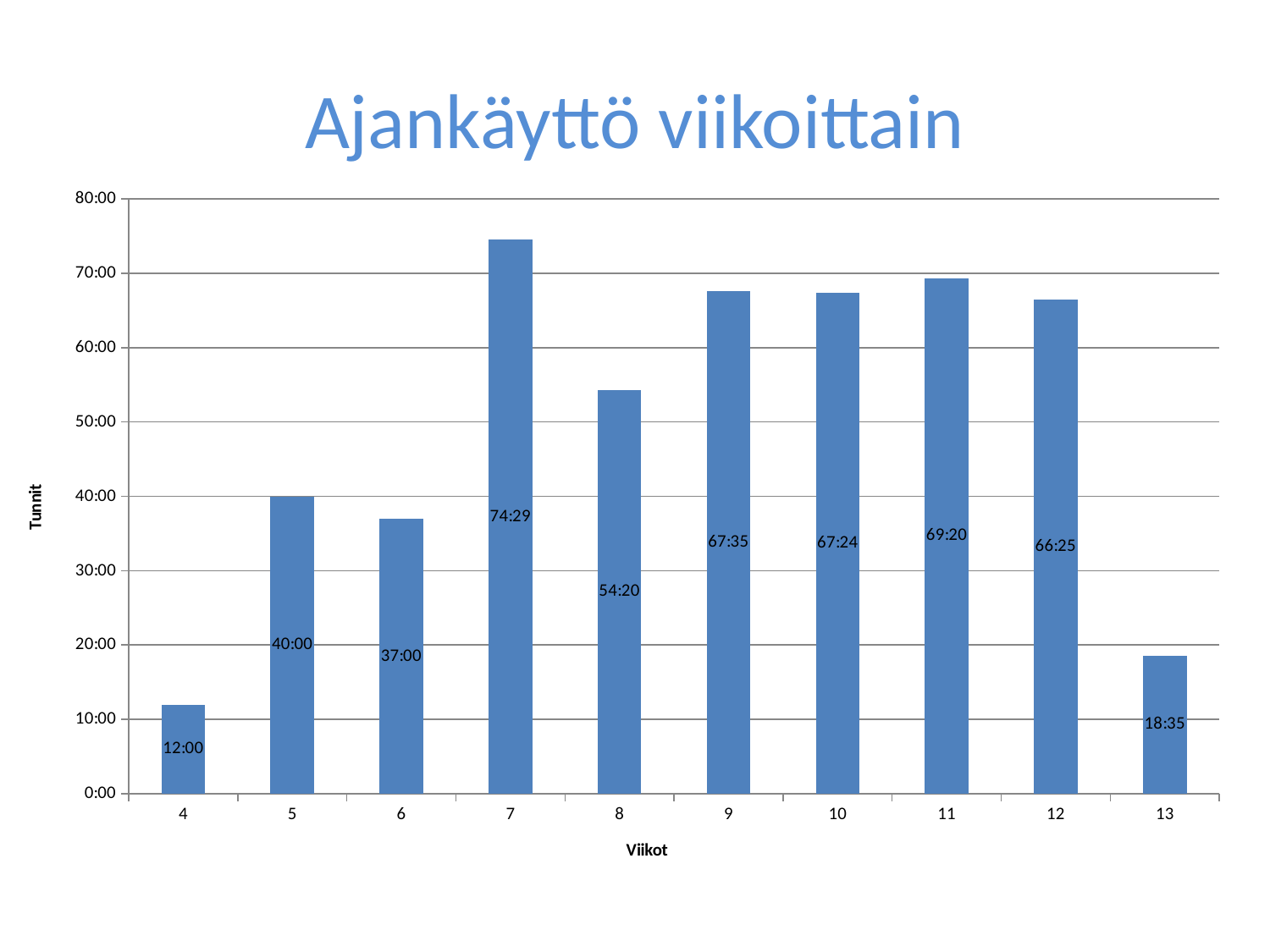
What is the difference between the values for week 5 and week 6? 3:00 What is the value for week 13? 18:35 What is the value for week 10? 67:24 What is the title of the chart? Ajankäyttö viikoittain Which week has the lowest value? 4 Is the value for week 8 greater or less than 50:00? greater How many weeks are shown on the x axis? 10 Which is larger, the value for week 11 or the value for week 12? week 11 What kind of chart is shown on the slide? bar chart What is the difference between the values for week 7 and week 4? 62:29 What is the value for week 7? 74:29 Which week has the highest value? 7